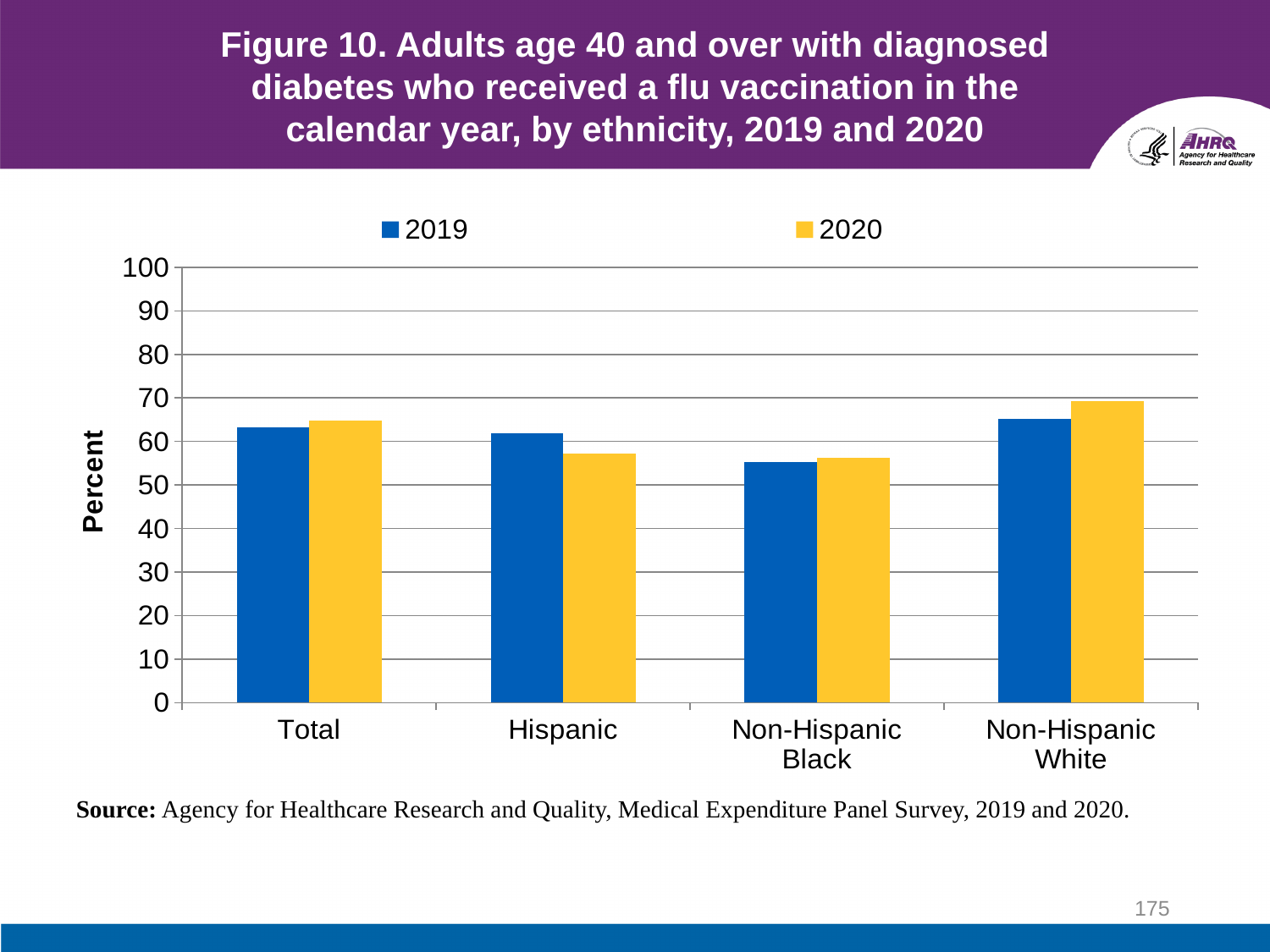
Which category has the highest value for 2020? Non-Hispanic White Is the 2019 value for Non-Hispanic Black greater or less than 60? less How many series does the legend list? 2 For Hispanic, which year has the larger value, 2019 or 2020? 2019 How many ethnicity categories are shown on the x axis? 4 Is the 2020 value for Non-Hispanic White greater or less than 60? greater Which category has the lowest value for 2019? Non-Hispanic Black Is the 2019 value for Total greater or less than 60? greater What is the label of the y axis? Percent For Non-Hispanic White, which year has the larger value, 2019 or 2020? 2020 What kind of chart is shown on the slide? bar chart Which colour represents the 2020 series in the legend? yellow